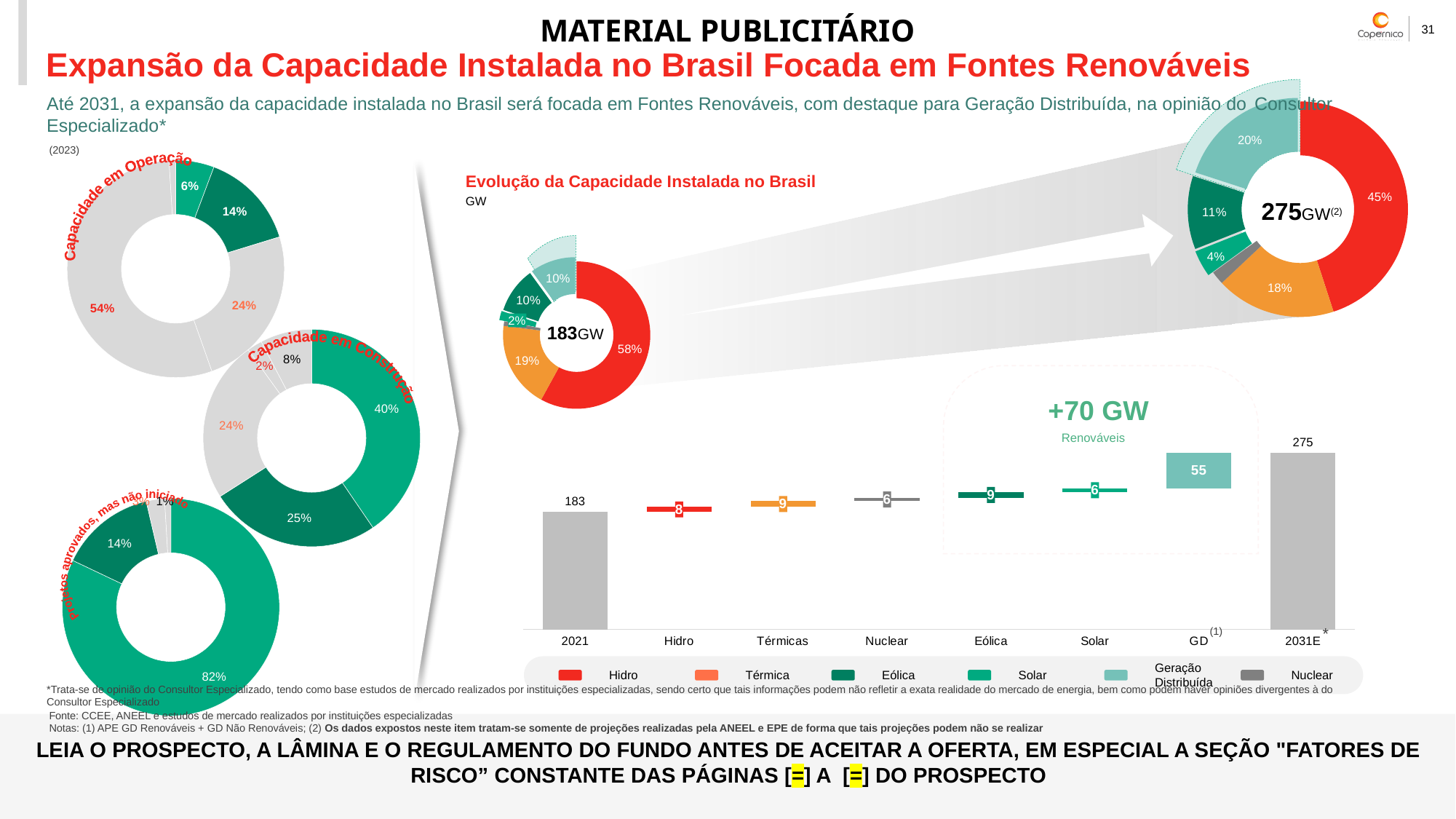
What kind of chart is the chart at the bottom right with the 2021 and 2031E values? Bar chart How many series does the legend below the bar chart list? 6 In the bar chart at the bottom right, what is the value shown for 2031E? 275 How many categories are shown on the x axis of the bar chart at the bottom right? 8 In the bar chart at the bottom right, what is the value shown for 2021? 183 In the 183GW donut chart under 'Evolução da Capacidade Instalada no Brasil', what share is shown for Hidro (the red segment)? 58% In the bar chart at the bottom right, which of the source categories (Hidro, Térmicas, Nuclear, Eólica, Solar, GD) has the largest value? GD In the 275GW donut chart, what share is shown for Geração Distribuída (the light teal segment)? 20% In the bar chart at the bottom right, what is the difference between the 2031E value and the 2021 value? 92 In the 'Projetos aprovados, mas não iniciados' donut chart on the left, what is the largest percentage shown? 82% In the bar chart at the bottom right, what is the value shown for GD? 55 In the bar chart at the bottom right, which is larger, the value for Hidro or the value for Térmicas? Térmicas